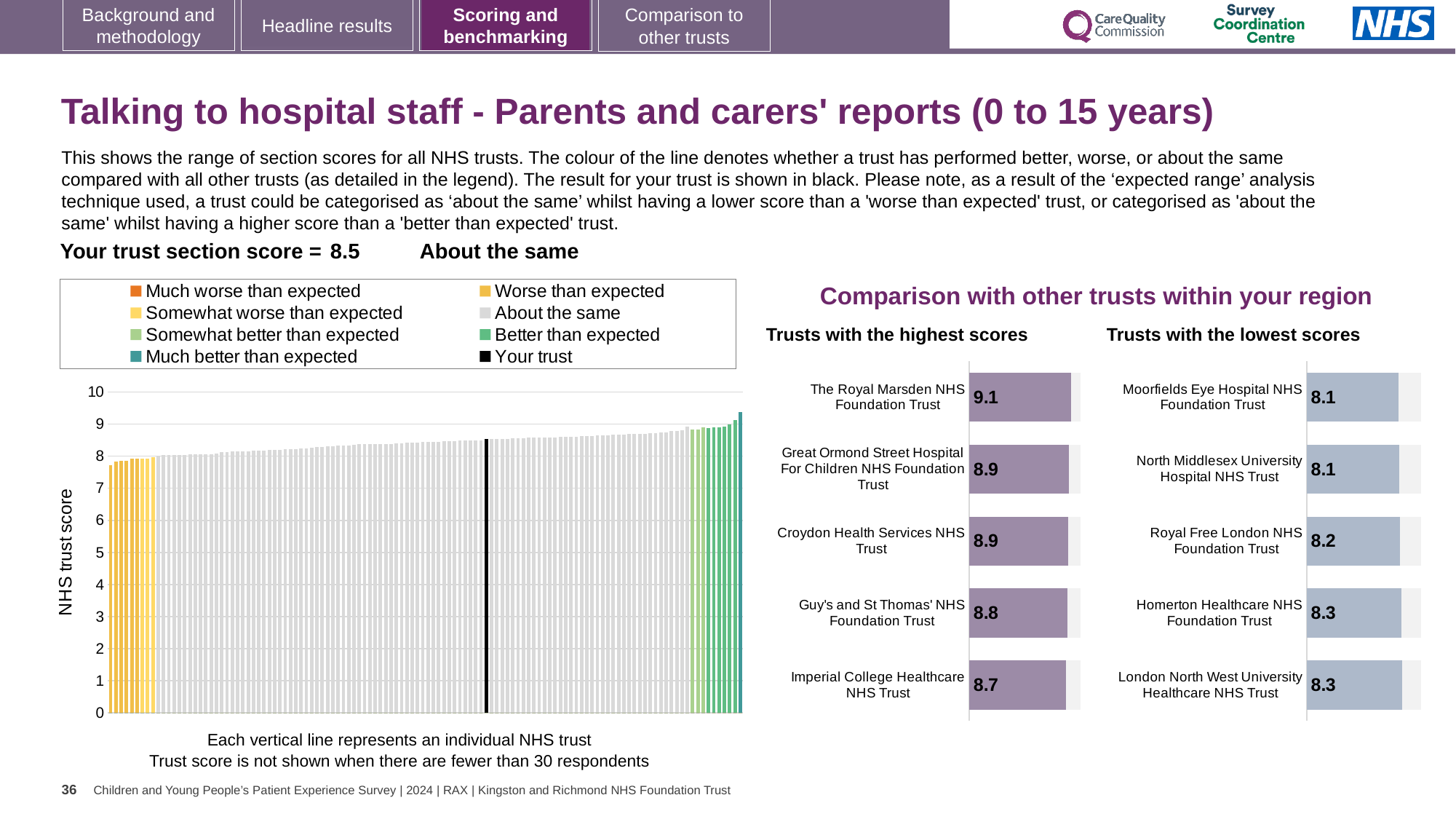
In the NHS trust score chart on the left, what is the section score for your trust (the black bar)? 8.5 In the 'Trusts with the lowest scores' chart, what is the score for Royal Free London NHS Foundation Trust? 8.2 How many entries does the legend of the NHS trust score chart on the left list? 8 In the 'Trusts with the highest scores' chart, what is the difference between the scores of The Royal Marsden NHS Foundation Trust and Imperial College Healthcare NHS Trust? 0.4 In the 'Trusts with the highest scores' chart, what is the score for Imperial College Healthcare NHS Trust? 8.7 In the 'Trusts with the lowest scores' chart, what is the difference between the scores of London North West University Healthcare NHS Trust and North Middlesex University Hospital NHS Trust? 0.2 In the 'Trusts with the lowest scores' chart, which is larger: the score for Royal Free London NHS Foundation Trust or Moorfields Eye Hospital NHS Foundation Trust? Royal Free London NHS Foundation Trust In the NHS trust score chart on the left, do the bar values rise or fall from left to right? rise In the 'Trusts with the highest scores' chart, what is the score for The Royal Marsden NHS Foundation Trust? 9.1 In the 'Trusts with the highest scores' chart, which trust has the highest score? The Royal Marsden NHS Foundation Trust In the 'Trusts with the lowest scores' chart, what is the score for Homerton Healthcare NHS Foundation Trust? 8.3 How many trusts are shown in the 'Trusts with the highest scores' chart? 5